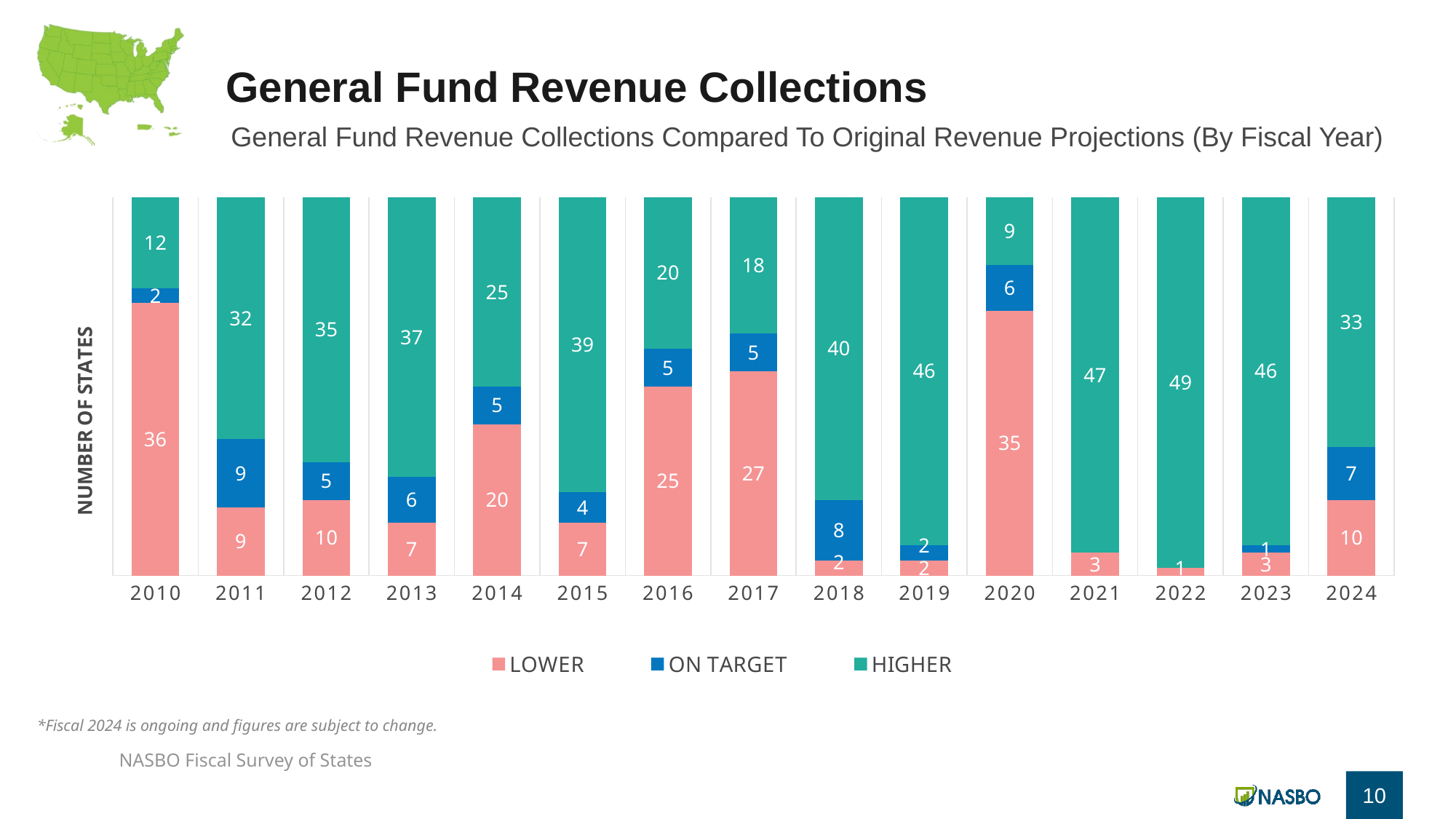
Which fiscal year has the lowest LOWER value? 2022 How many states had general fund revenue collections lower than projections in fiscal 2010? 36 How many fiscal years are shown on the x axis? 15 What is the total of the stacked bar for fiscal 2017? 50 Which fiscal year has the highest HIGHER value? 2022 What kind of chart is shown on the slide? Stacked bar chart How many series does the legend list? 3 What is the label on the vertical axis? NUMBER OF STATES What is the difference between the LOWER values for 2020 and 2024? 25 Which is larger, the HIGHER value for 2014 or the HIGHER value for 2016? 2014 What is the HIGHER value for fiscal 2022? 49 How many states were ON TARGET in fiscal 2018? 8